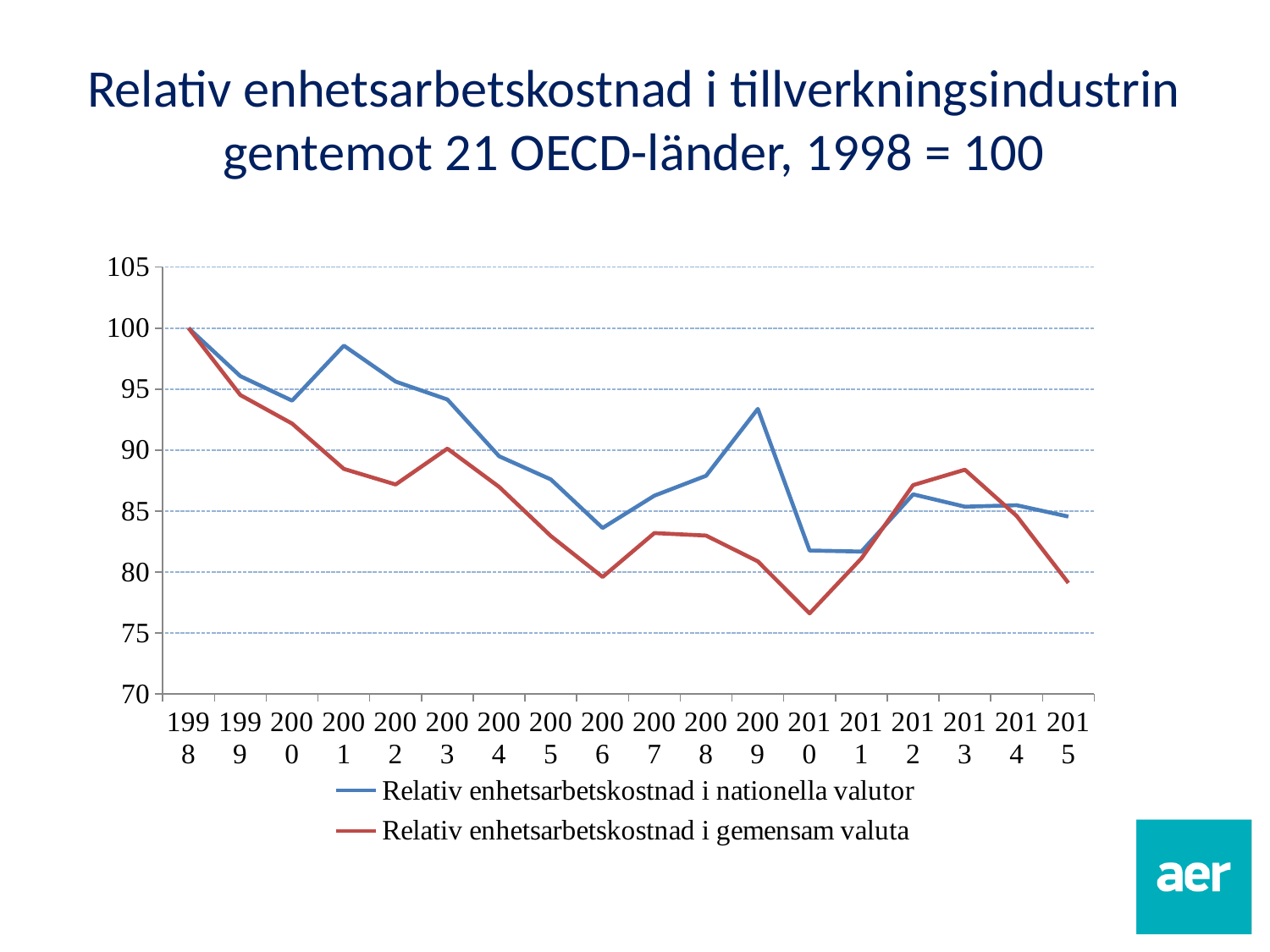
Is the value for 'Relativ enhetsarbetskostnad i nationella valutor' in 2009 greater or less than 90? greater In which year is 'Relativ enhetsarbetskostnad i gemensam valuta' at its lowest? 2010 In 2013, which series has the higher value: 'Relativ enhetsarbetskostnad i nationella valutor' or 'Relativ enhetsarbetskostnad i gemensam valuta'? Relativ enhetsarbetskostnad i gemensam valuta How many years are plotted along the x axis? 18 In which year is 'Relativ enhetsarbetskostnad i nationella valutor' at its highest? 1998 In 2009, which series has the higher value: 'Relativ enhetsarbetskostnad i nationella valutor' or 'Relativ enhetsarbetskostnad i gemensam valuta'? Relativ enhetsarbetskostnad i nationella valutor How many series does the legend list? 2 What kind of chart is shown on the slide? Line chart Is the value for 'Relativ enhetsarbetskostnad i gemensam valuta' in 2010 greater or less than 80? less Overall, does 'Relativ enhetsarbetskostnad i gemensam valuta' rise or fall from 1998 to 2015? Fall What is the value of 'Relativ enhetsarbetskostnad i nationella valutor' in 1998? 100 Is the value for 'Relativ enhetsarbetskostnad i gemensam valuta' in 2013 greater or less than 85? greater